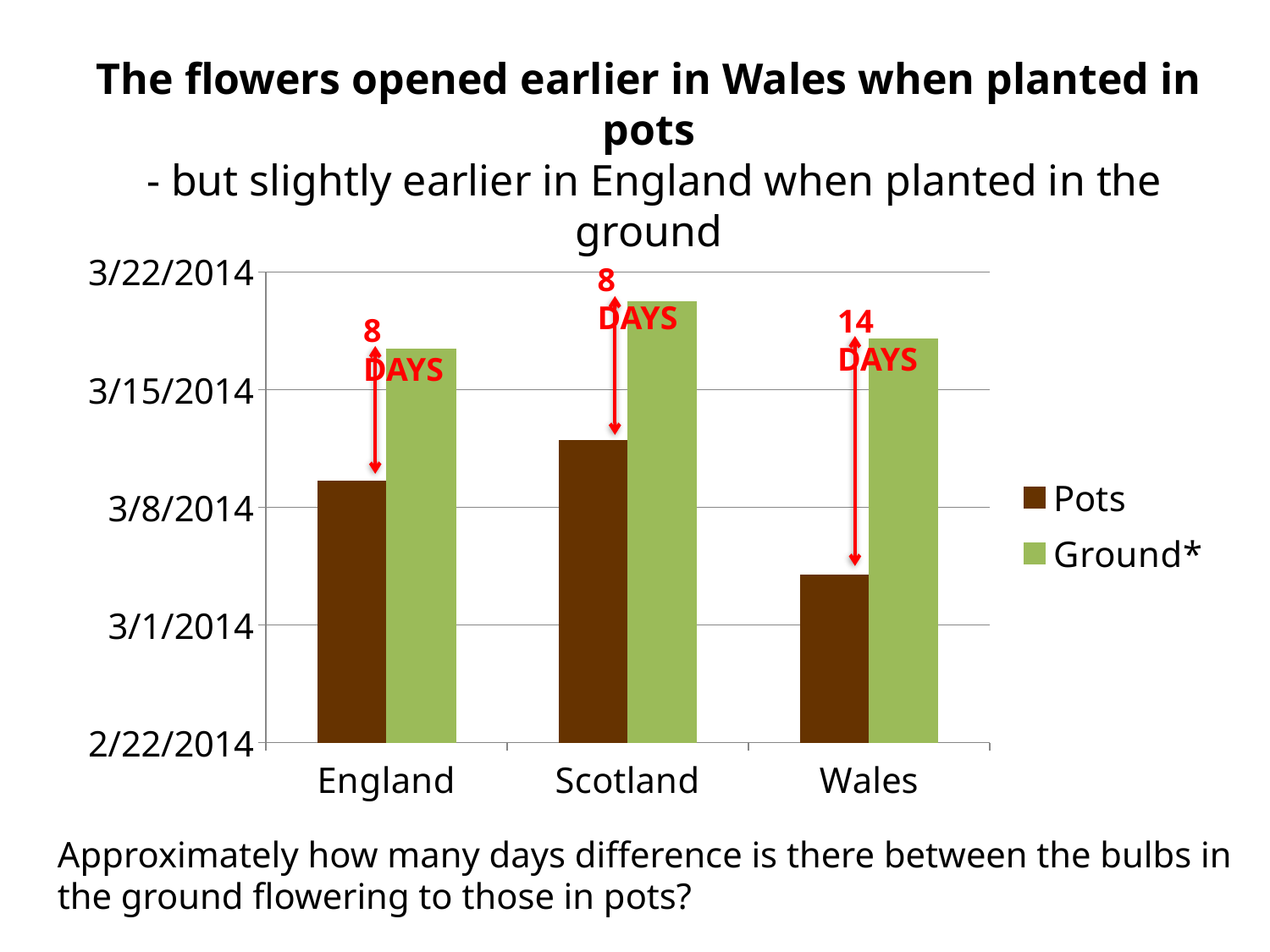
Is the Pots value for Wales earlier or later than 3/8/2014? earlier According to the red annotation, how many days difference is there between pots and ground for Scotland? 8 days How many countries are shown on the x axis of the chart? 3 Which country has the highest (latest) value for the Pots series? Scotland How many series does the chart's legend list? 2 Which country has the highest (latest) value for the Ground* series? Scotland According to the red annotation, how many days difference is there between pots and ground for England? 8 days Which country has the lowest (earliest) value for the Pots series? Wales What kind of chart is shown on the slide? bar chart Is the Ground* value for Scotland earlier or later than 3/15/2014? later According to the red annotation, how many days difference is there between pots and ground for Wales? 14 days What are the two series named in the chart's legend? Pots and Ground*